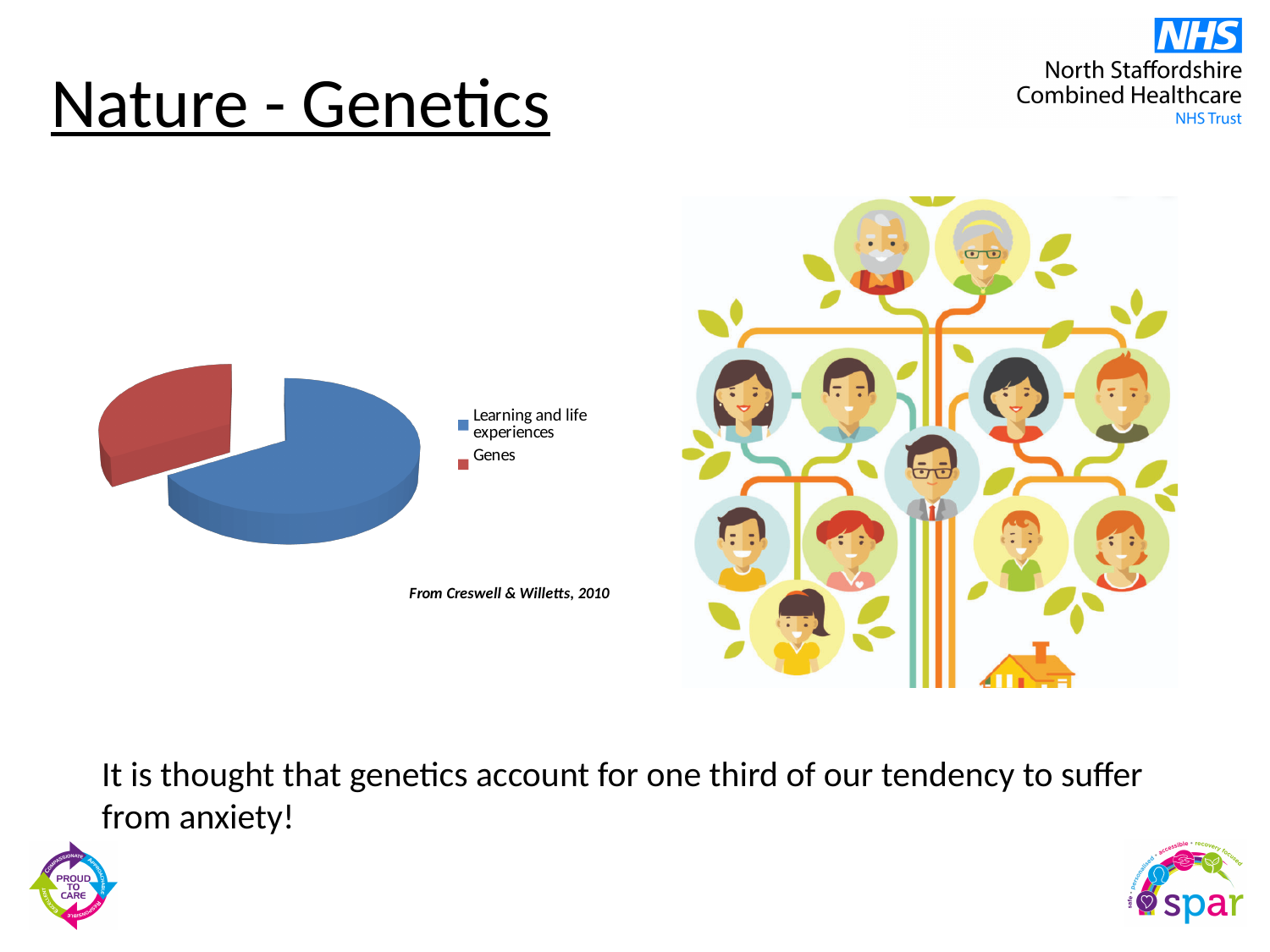
What kind of chart is shown on the slide? pie chart How many slices does the pie chart have? 2 According to the caption under the pie chart, what source is the chart from? Creswell & Willetts, 2010 In the pie chart, which is larger: the slice for Genes or the slice for Learning and life experiences? Learning and life experiences Which slice of the pie chart is the largest? Learning and life experiences What colour is the Genes slice in the pie chart? red How many entries does the pie chart's legend list? 2 Which slice of the pie chart is the smallest? Genes